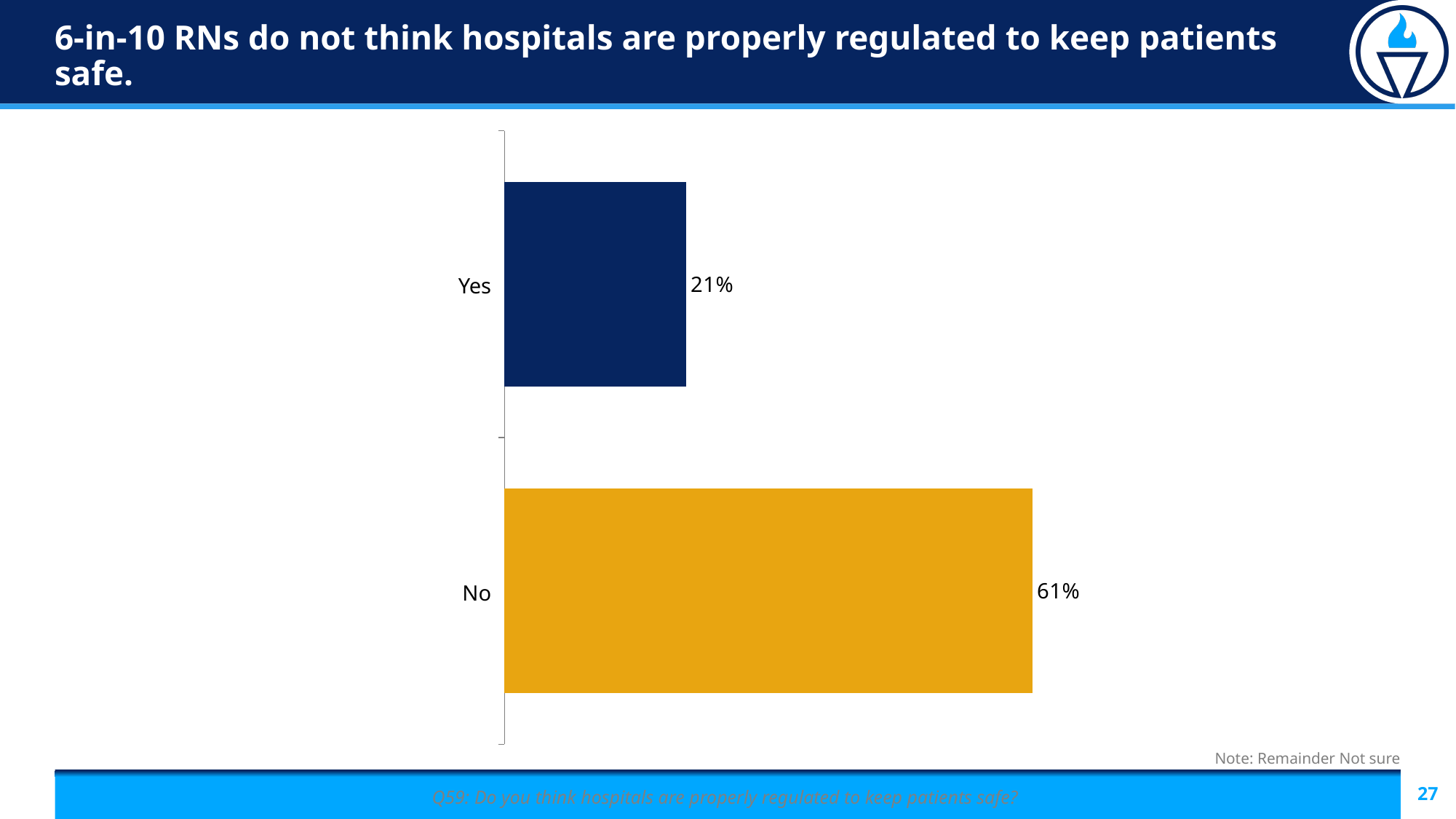
Which response has the highest value? No What is the combined percentage of the Yes and No responses? 82% Which is larger, the value for Yes or the value for No? No What percentage of RNs answered Yes? 21% What kind of chart is shown on the slide? Bar chart What colour is the bar for the No response? Orange Which response has the lowest value? Yes What is the difference in percentage points between the No and Yes responses? 40 percentage points How many response categories are shown in the chart? 2 What percentage of RNs answered No? 61% According to the note on the slide, what does the remainder of respondents represent? Not sure